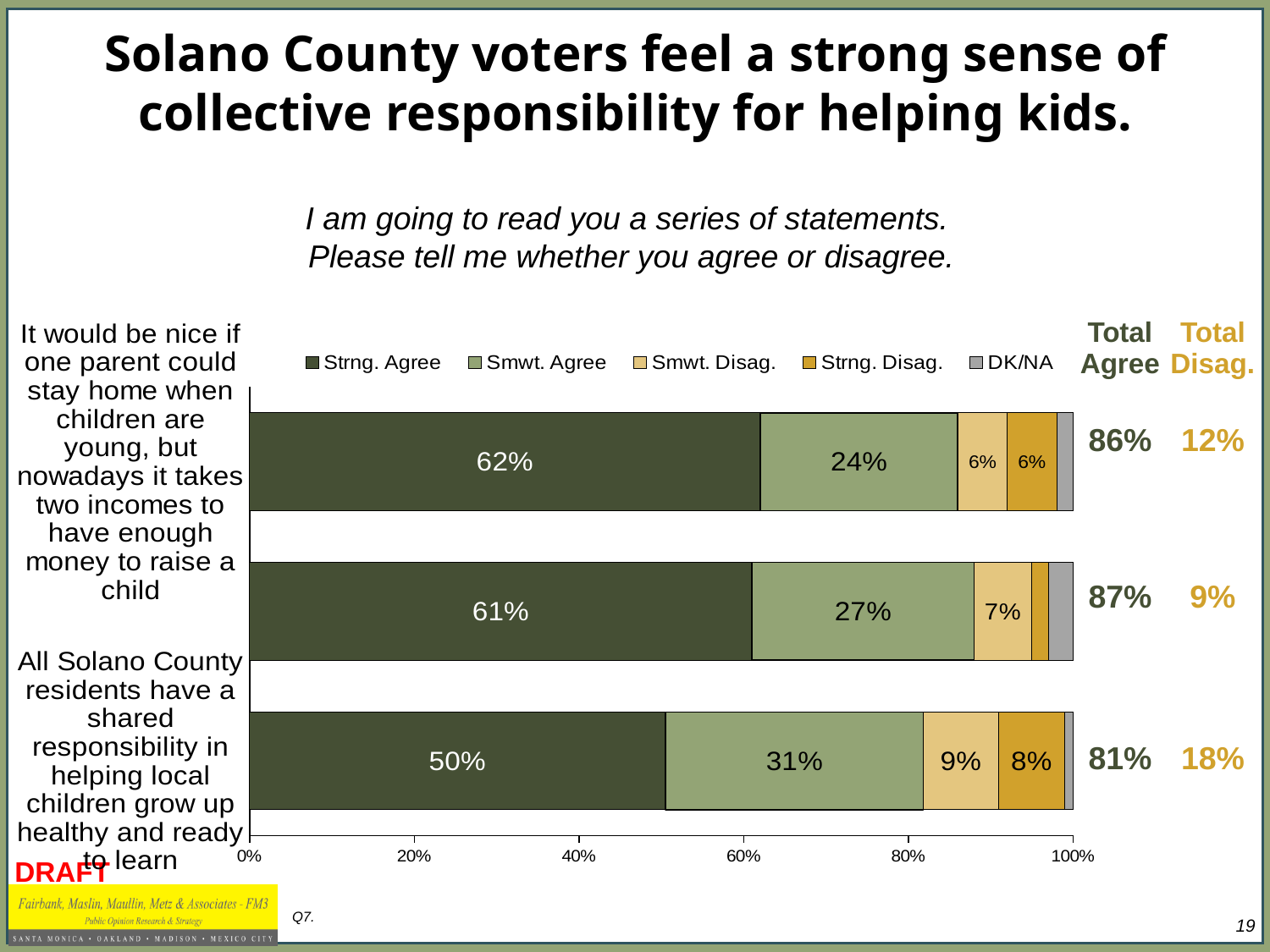
What kind of chart is shown on the slide? Stacked bar chart By how many percentage points does the Strng. Agree share for the one-parent/two-incomes statement exceed that for the shared responsibility statement? 12 percentage points Which of the three statements has the lowest Total Agree figure? All Solano County residents have a shared responsibility in helping local children grow up healthy and ready to learn What percentage of voters strongly agree that all Solano County residents have a shared responsibility in helping local children grow up healthy and ready to learn? 50% What is the Total Disag. figure for the statement that it would be nice if one parent could stay home but it takes two incomes to raise a child? 12% What is the Total Agree figure for the statement about all Solano County residents having a shared responsibility in helping local children? 81% How many series does the chart legend list? 5 What colour represents Strng. Agree in the chart legend? Dark green How many bars are plotted in the chart? 3 What percentage somewhat disagree with the statement about all Solano County residents having a shared responsibility in helping local children? 9% Which has a larger Strng. Agree share: the statement about one parent staying home but needing two incomes, or the statement about all Solano County residents having a shared responsibility? The statement about one parent staying home but needing two incomes What percentage somewhat agree with the statement that it would be nice if one parent could stay home but nowadays it takes two incomes to raise a child? 24%